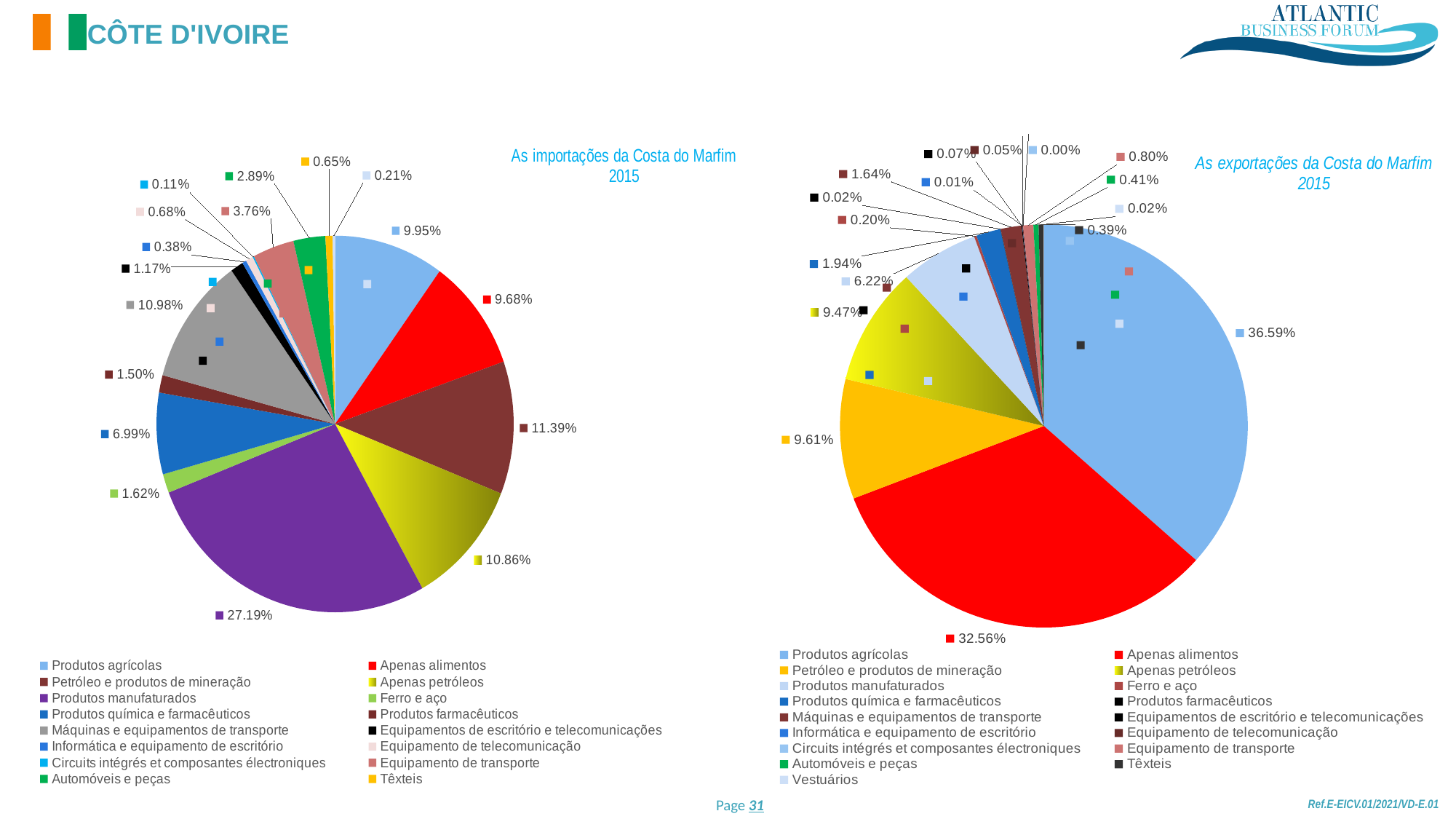
In the 'As exportações da Costa do Marfim 2015' pie chart, what share is shown for Produtos agrícolas? 36.59% In the 'As importações da Costa do Marfim 2015' pie chart, what share is shown for Máquinas e equipamentos de transporte? 10.98% In the 'As importações da Costa do Marfim 2015' pie chart, what is the difference between the shares of Petróleo e produtos de mineração and Apenas petróleos? 0.53% In the 'As exportações da Costa do Marfim 2015' pie chart, what share is shown for Produtos manufaturados? 6.22% In the 'As exportações da Costa do Marfim 2015' pie chart, what share is shown for Apenas alimentos? 32.56% In the 'As importações da Costa do Marfim 2015' pie chart, which category has the largest slice? Produtos manufaturados How many entries does the legend of the 'As exportações da Costa do Marfim 2015' chart list? 17 In the 'As importações da Costa do Marfim 2015' pie chart, what share is shown for Produtos manufaturados? 27.19% In the 'As exportações da Costa do Marfim 2015' pie chart, which category has the largest slice? Produtos agrícolas In the 'As exportações da Costa do Marfim 2015' pie chart, what is the difference between the shares of Petróleo e produtos de mineração and Apenas petróleos? 0.14% What type of chart is used for 'As importações da Costa do Marfim 2015'? Pie chart In the 'As importações da Costa do Marfim 2015' pie chart, which is larger: Produtos química e farmacêuticos or Equipamento de transporte? Produtos química e farmacêuticos